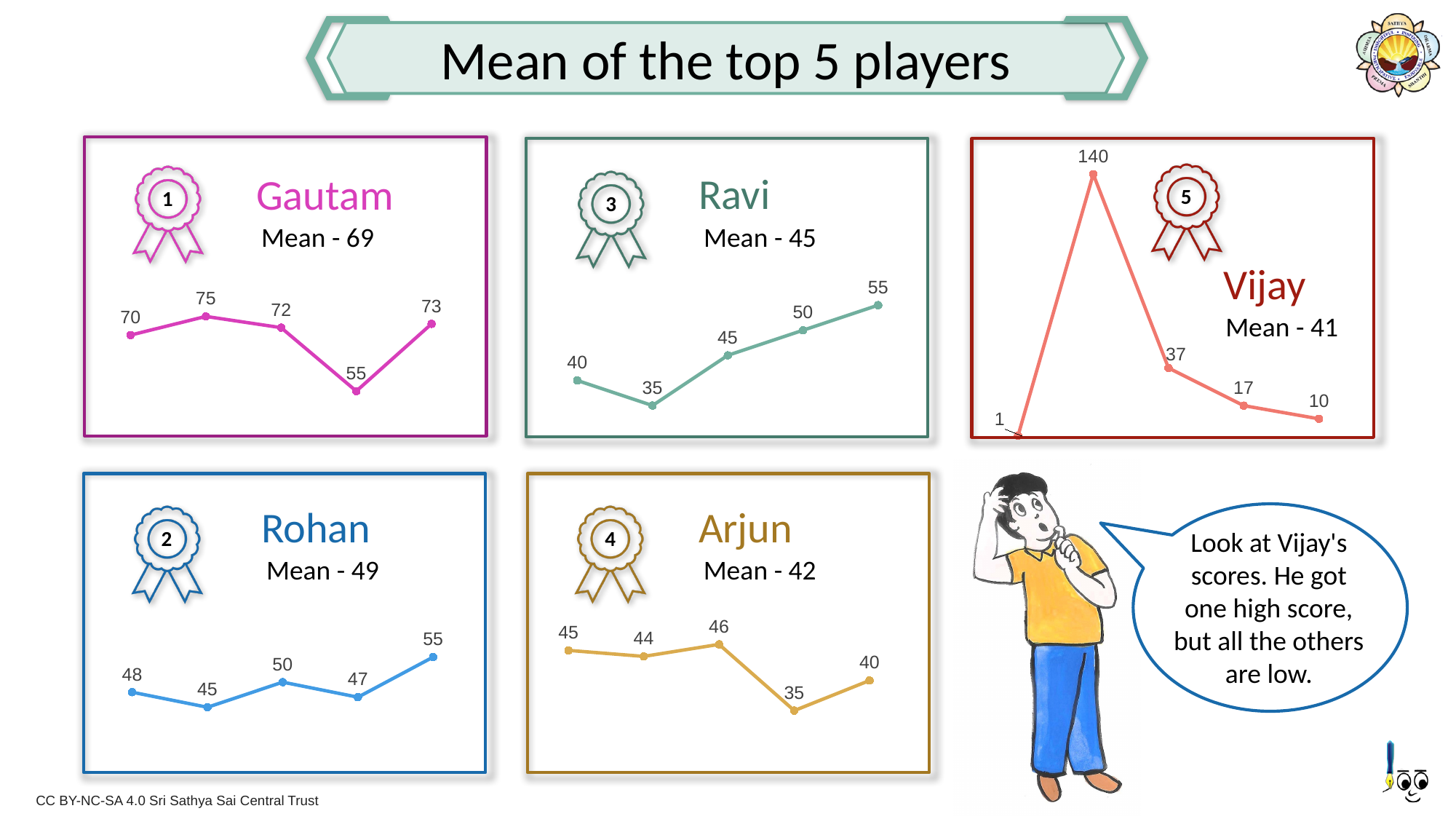
In Rohan's chart, how many data points are plotted? 5 In Vijay's chart, do the values rise or fall from the second point to the last point? fall In Ravi's chart, what is the value of the last point? 55 In Vijay's chart, what is the value of the second point? 140 In Ravi's chart, what is the lowest value plotted? 35 How many line charts are shown on the slide? 5 In Rohan's chart, what is the difference between the last point and the first point? 7 What kind of chart is used to show Gautam's scores? line chart In Arjun's chart, which is larger, the first point or the last point? the first point In Vijay's chart, what is the difference between the highest value and the lowest value? 139 In Gautam's chart, what is the value of the fourth point? 55 In Gautam's chart, what is the highest value plotted? 75